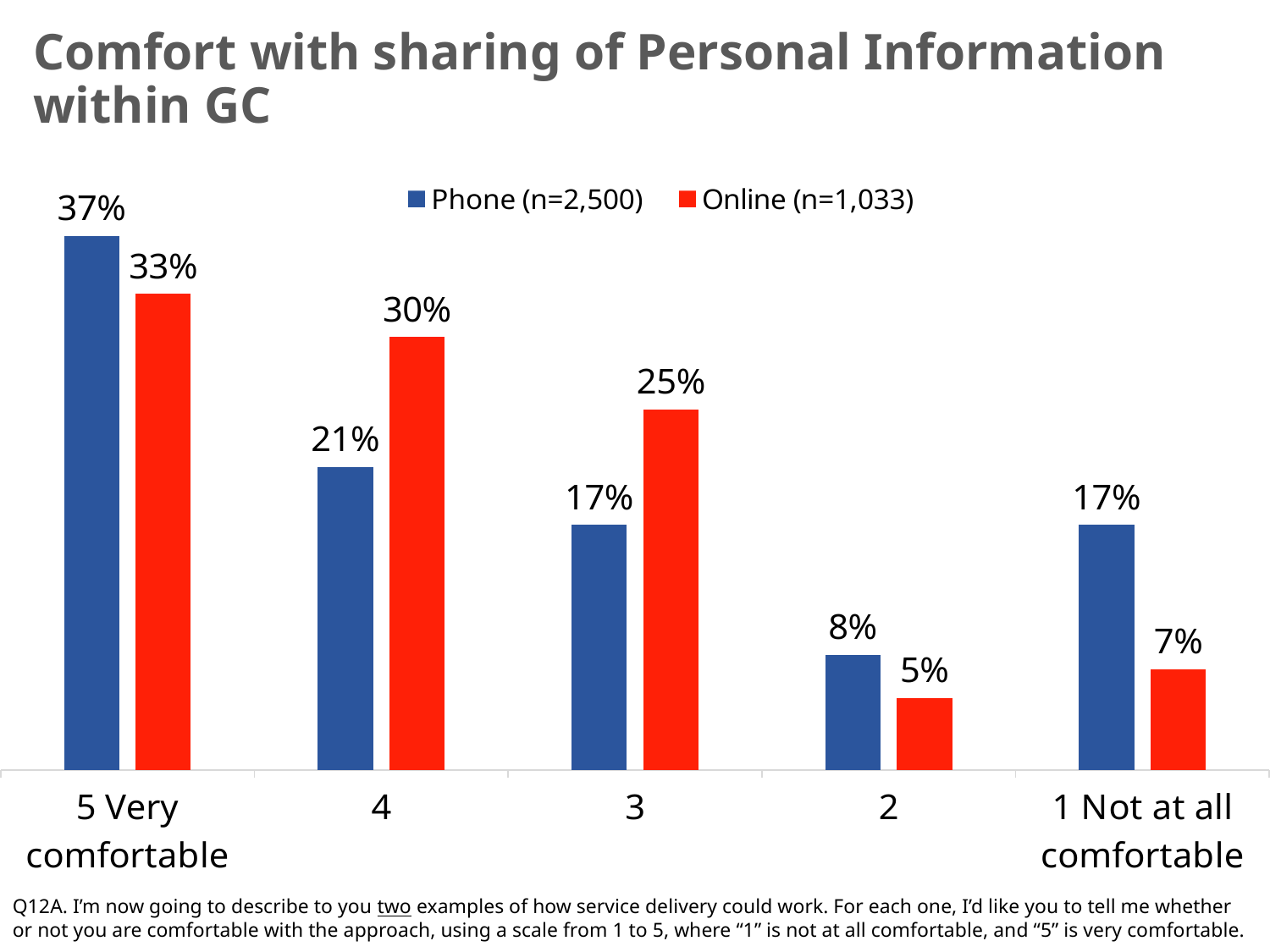
How many series does the legend list? 2 What is the Online value for "4"? 30% How many categories are shown on the x axis? 5 Which category has the highest Online value? 5 Very comfortable Which category has the lowest Phone value? 2 What is the Phone value for "5 Very comfortable"? 37% What is the title of the chart? Comfort with sharing of Personal Information within GC What kind of chart is shown on the slide? Bar chart What colour represents the Online (n=1,033) series? Red Which is larger for "2": the Phone value or the Online value? Phone What is the Phone value for "1 Not at all comfortable"? 17% What is the difference between the Phone and Online values for "3"? 8%